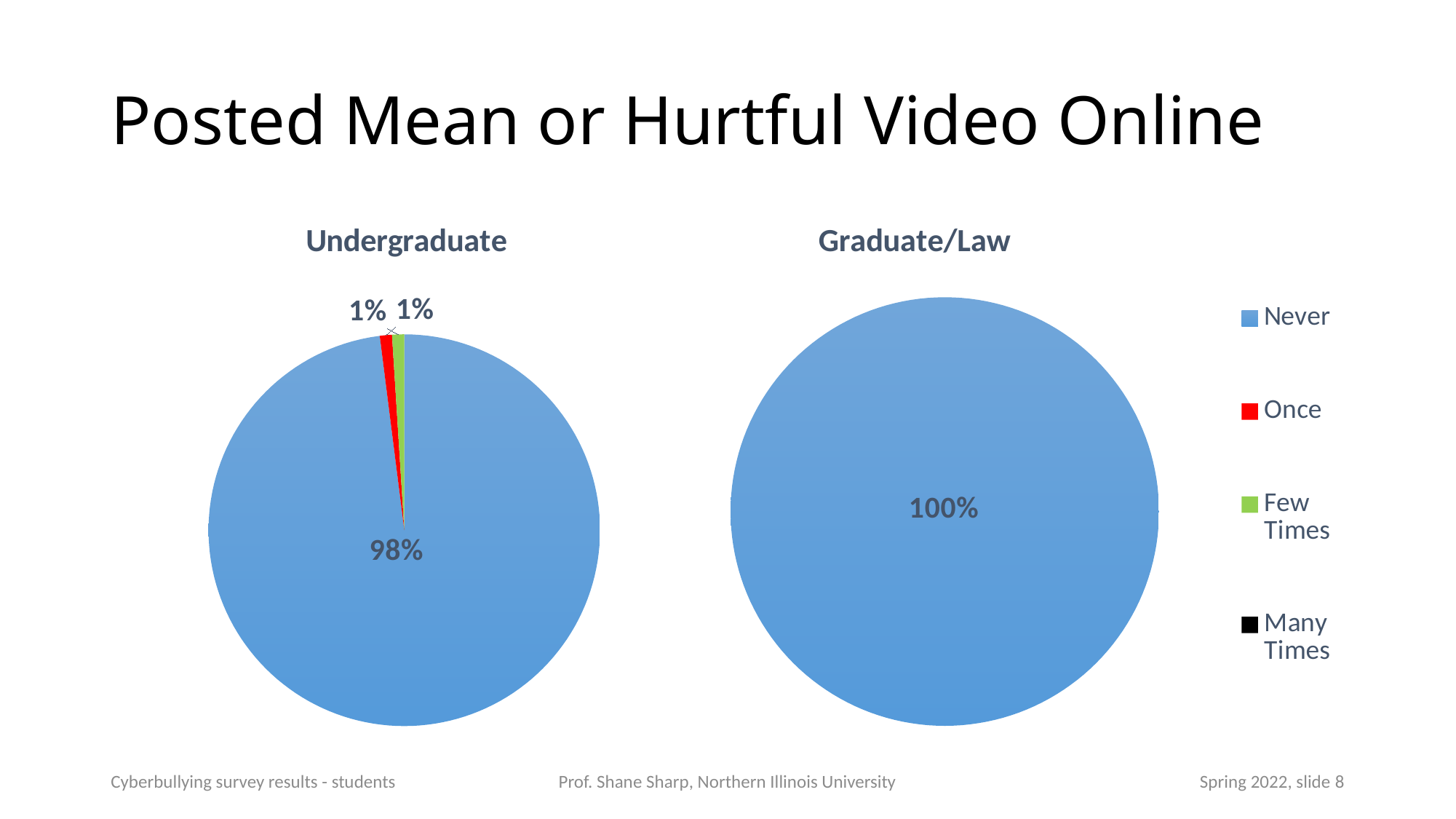
In the Undergraduate chart, what share of respondents answered Never? 98% Which chart has the larger Never share, Undergraduate or Graduate/Law? Graduate/Law What is the title of the chart on the right? Graduate/Law How many slices with printed labels does the Undergraduate chart show? 3 What kind of chart is the Undergraduate chart? Pie chart In the Undergraduate chart, what colour is the Once slice? Red In the Undergraduate chart, what share of respondents answered Few Times? 1% How many entries does the legend list? 4 In the Undergraduate chart, what share of respondents answered Once? 1% In the Undergraduate chart, what is the difference between the Never share and the Once share? 97% In the Graduate/Law chart, what share of respondents answered Never? 100% In the Undergraduate chart, which response has the largest slice? Never